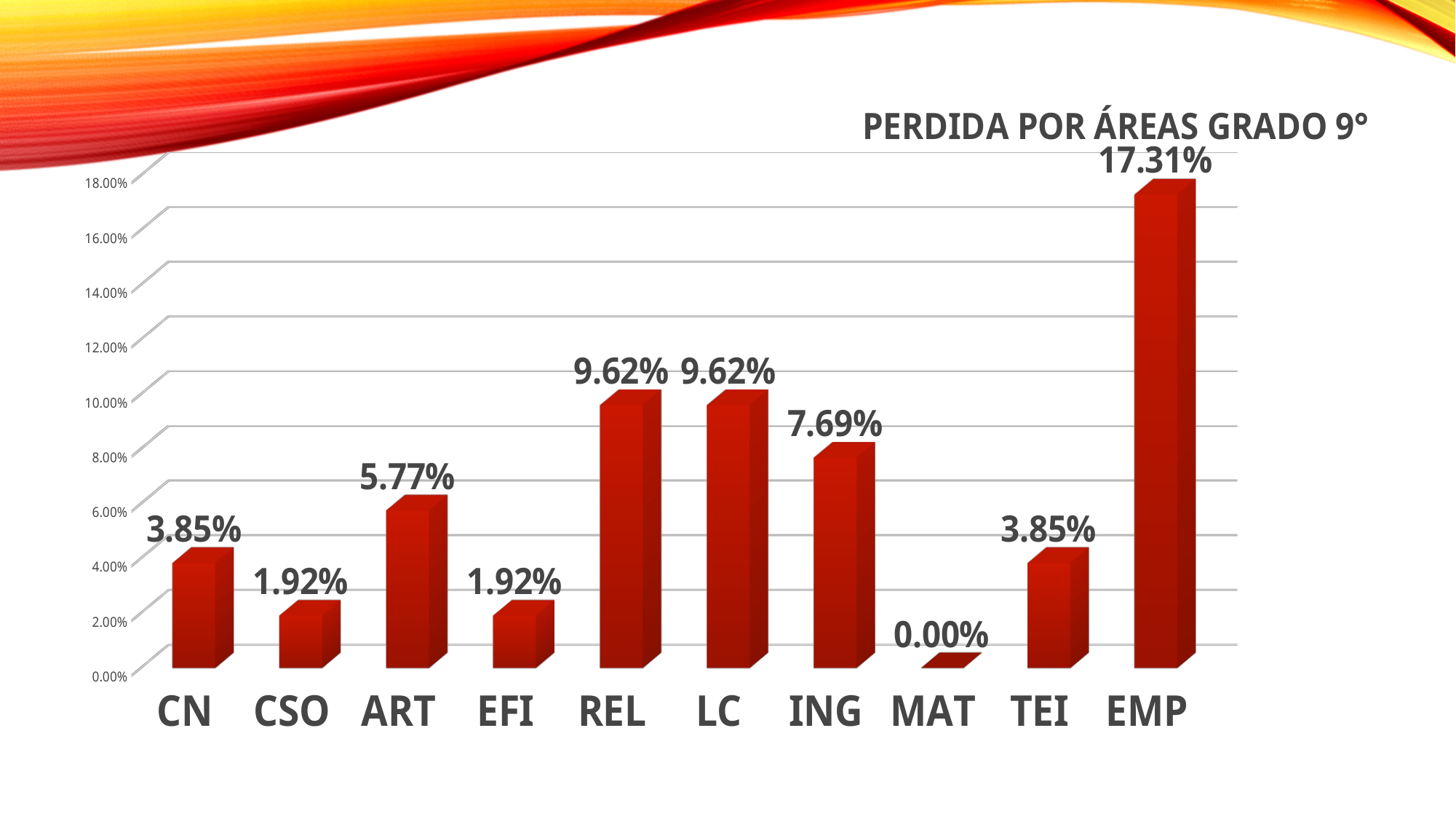
Which category has the highest value? EMP How many categories are shown on the x axis? 10 What is the value for ING? 7.69% Which category has the lowest value? MAT What is the difference between the values for EMP and REL? 7.69% What is the value for ART? 5.77% Is the value for EMP greater or less than 16.00%? greater What is the difference between the values for ART and CSO? 3.85% Which is larger, the value for ING or the value for TEI? ING What kind of chart is shown on the slide? Bar chart What is the value for EMP? 17.31% What is the title of the chart? PERDIDA POR ÁREAS GRADO 9°